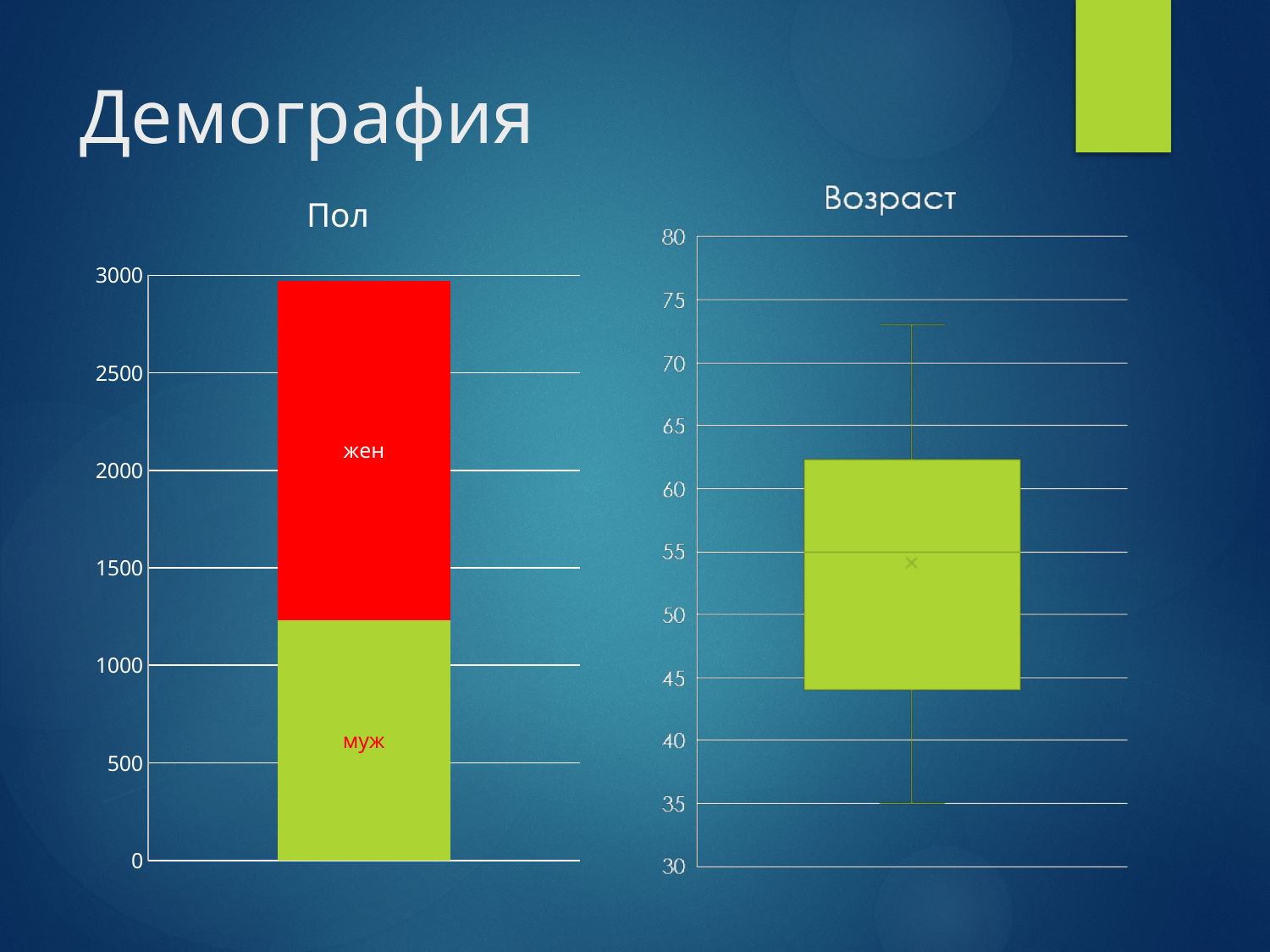
In the chart titled "Пол", is the value for "муж" greater or less than 1000? greater In the chart titled "Возраст", is the top edge of the box greater or less than 60? greater In the chart titled "Возраст", is the bottom of the lower whisker greater or less than 40? less In the chart titled "Пол", which segment is larger, "жен" or "муж"? жен What kind of chart is the chart titled "Пол"? bar chart In the chart titled "Пол", how many bars are plotted? 1 What kind of chart is the chart titled "Возраст"? box plot In the chart titled "Пол", how many segments make up the stacked bar? 2 In the chart titled "Пол", what colour is the "жен" segment? red